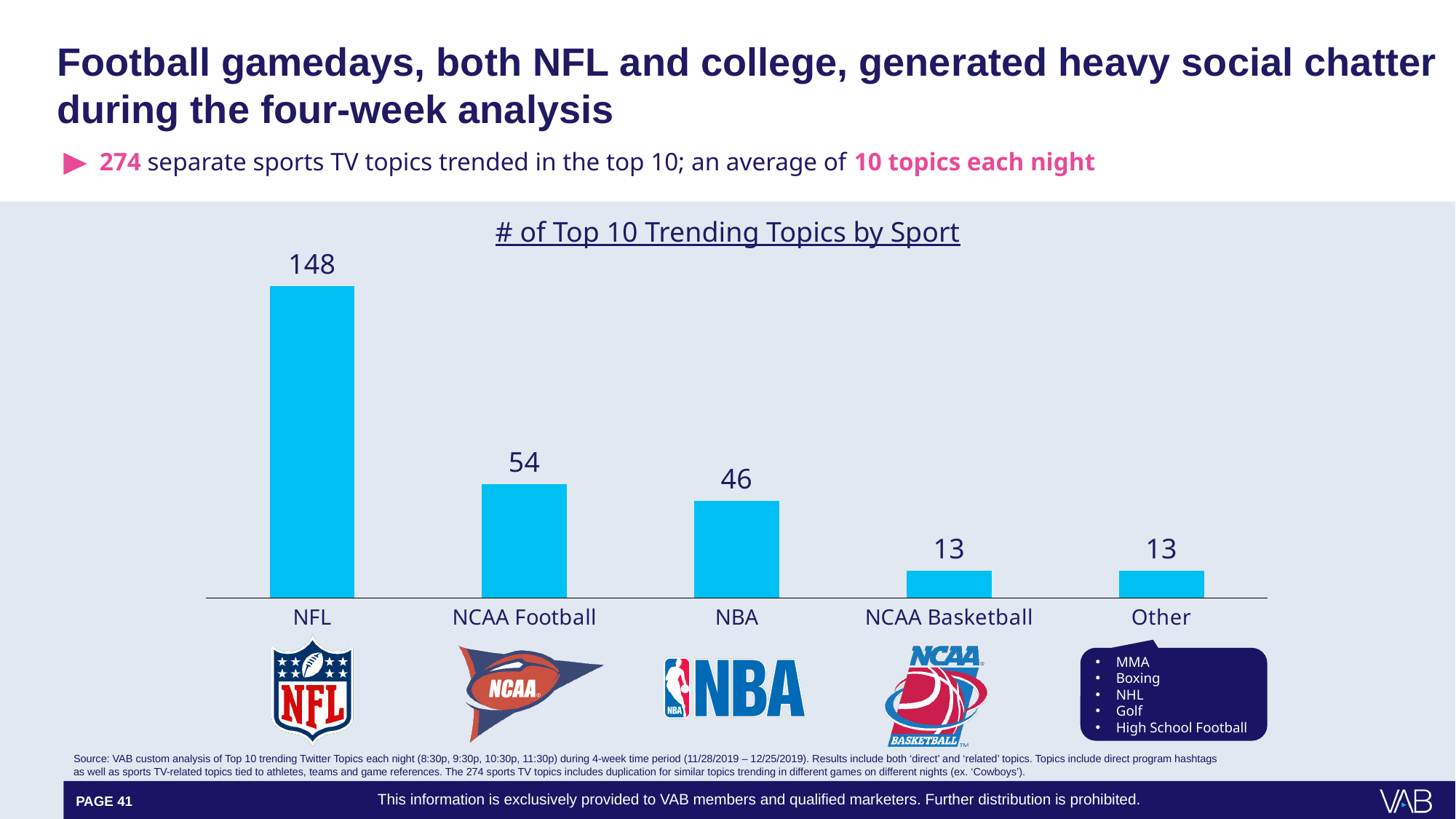
What is the title of the chart? # of Top 10 Trending Topics by Sport Which sport has the highest number of Top 10 trending topics? NFL What is the difference between the NFL and NCAA Football values? 94 What kind of chart is shown on the slide? Bar chart What is the number of Top 10 trending topics for NCAA Football? 54 What is the number of Top 10 trending topics for NCAA Basketball? 13 Which is larger, the value for NBA or the value for NCAA Basketball? NBA What is the difference between the NCAA Football and NBA values? 8 What is the number of Top 10 trending topics for NFL? 148 What is the number of Top 10 trending topics for NBA? 46 What is the total of the NCAA Basketball and Other values? 26 How many categories are shown in the chart? 5